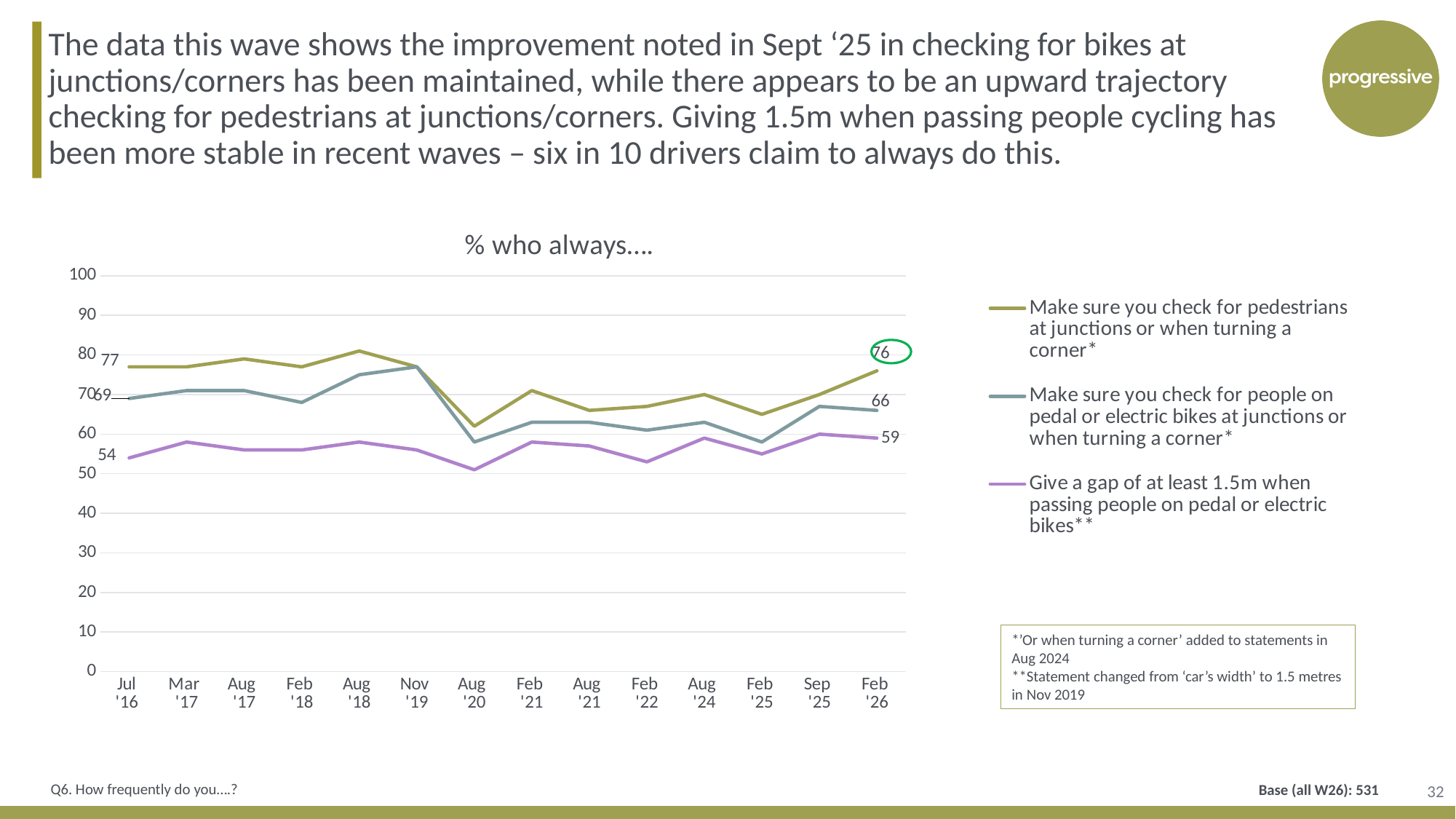
What is the value for 'Make sure you check for pedestrians at junctions or when turning a corner' in Jul '16? 77 What is the value for 'Make sure you check for people on pedal or electric bikes at junctions or when turning a corner' in Feb '26? 66 How many series does the legend list? 3 Which series has the highest value in Feb '26? Make sure you check for pedestrians at junctions or when turning a corner Which series has the lowest value in Jul '16? Give a gap of at least 1.5m when passing people on pedal or electric bikes What is the title of the chart? % who always.... Is the value for 'Give a gap of at least 1.5m when passing people on pedal or electric bikes' in Aug '20 greater or less than 60? less How many time points are shown on the x axis? 14 What is the value for 'Make sure you check for pedestrians at junctions or when turning a corner' in Feb '26? 76 What is the value for 'Give a gap of at least 1.5m when passing people on pedal or electric bikes' in Jul '16? 54 What type of chart is shown on the slide? line chart What is the difference between the Feb '26 values for checking for pedestrians (76) and checking for people on bikes (66)? 10